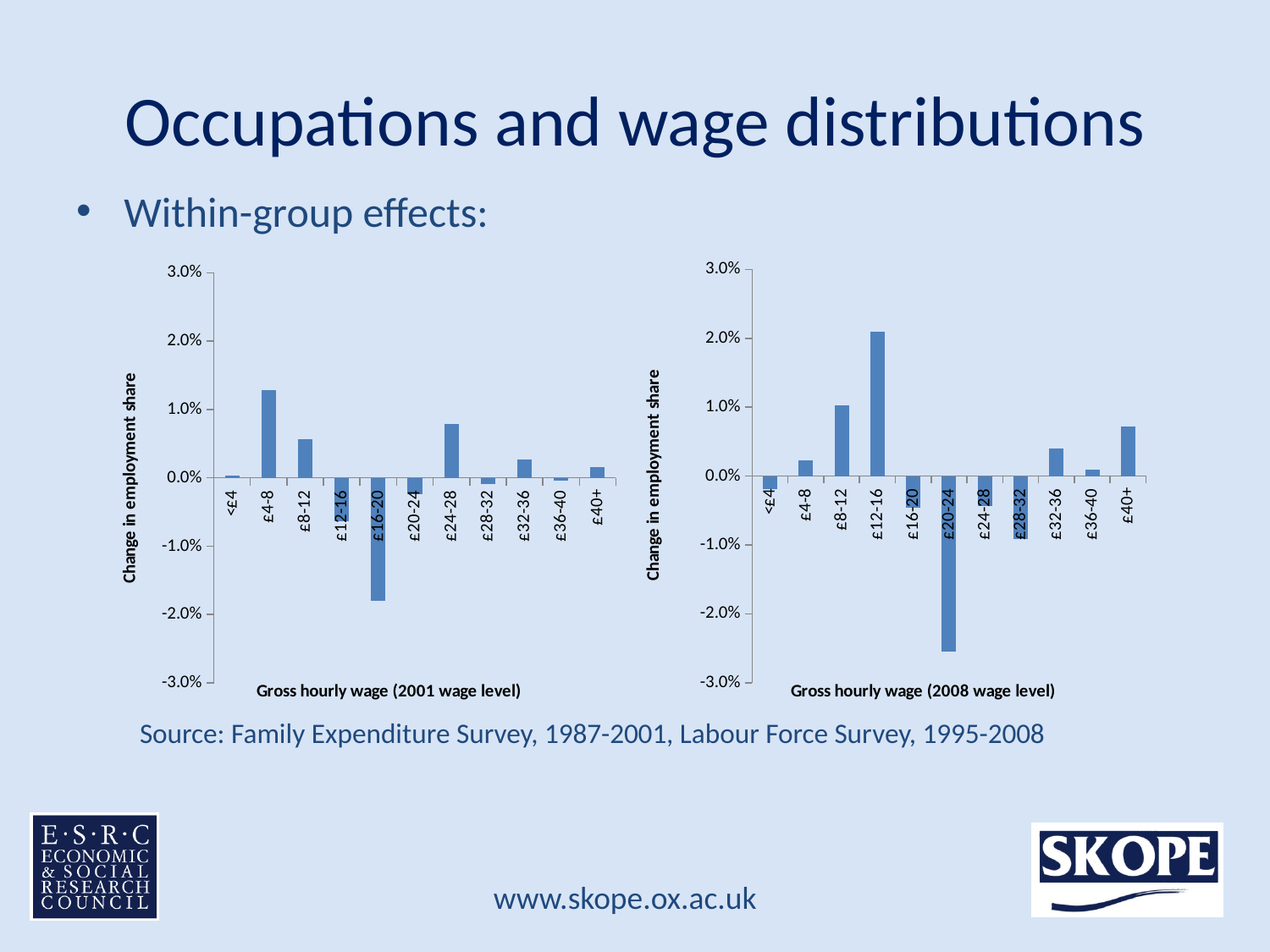
In the left chart (2001 wage level), which wage category has the lowest change in employment share? £16-20 In the right chart (2008 wage level), which wage category has the lowest change in employment share? £20-24 What kind of chart is the left chart (2001 wage level)? bar chart In the left chart (2001 wage level), which wage category has the highest change in employment share? £4-8 What is the y-axis title of the left chart (2001 wage level)? Change in employment share In the left chart (2001 wage level), is the value for £4-8 greater or less than 1.0%? greater How many wage categories are shown on the x axis of the right chart (2008 wage level)? 11 In the right chart (2008 wage level), is the value for £20-24 greater or less than -2.0%? less In the left chart (2001 wage level), which is larger, the value for £8-12 or the value for £24-28? £24-28 In the right chart (2008 wage level), which is larger, the value for £40+ or the value for £32-36? £40+ In the right chart (2008 wage level), which wage category has the highest change in employment share? £12-16